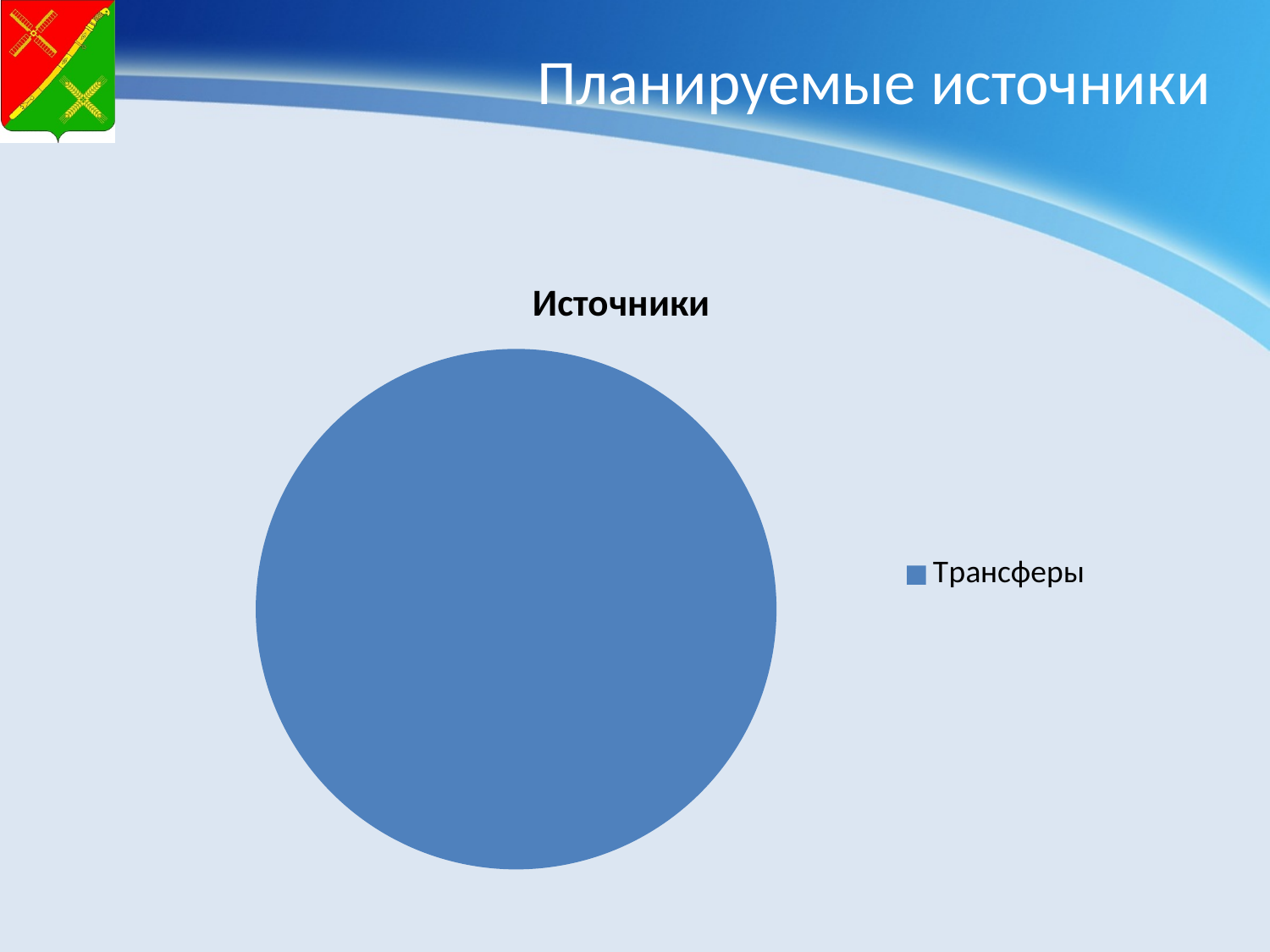
What share of the pie does the slice for Трансферы take up? 100% What kind of chart is shown on the slide? pie chart How many entries does the legend of the pie chart list? 1 What is the name of the only category shown in the pie chart's legend? Трансферы How many categories (slices) does the pie chart contain? 1 What is the title of the pie chart? Источники